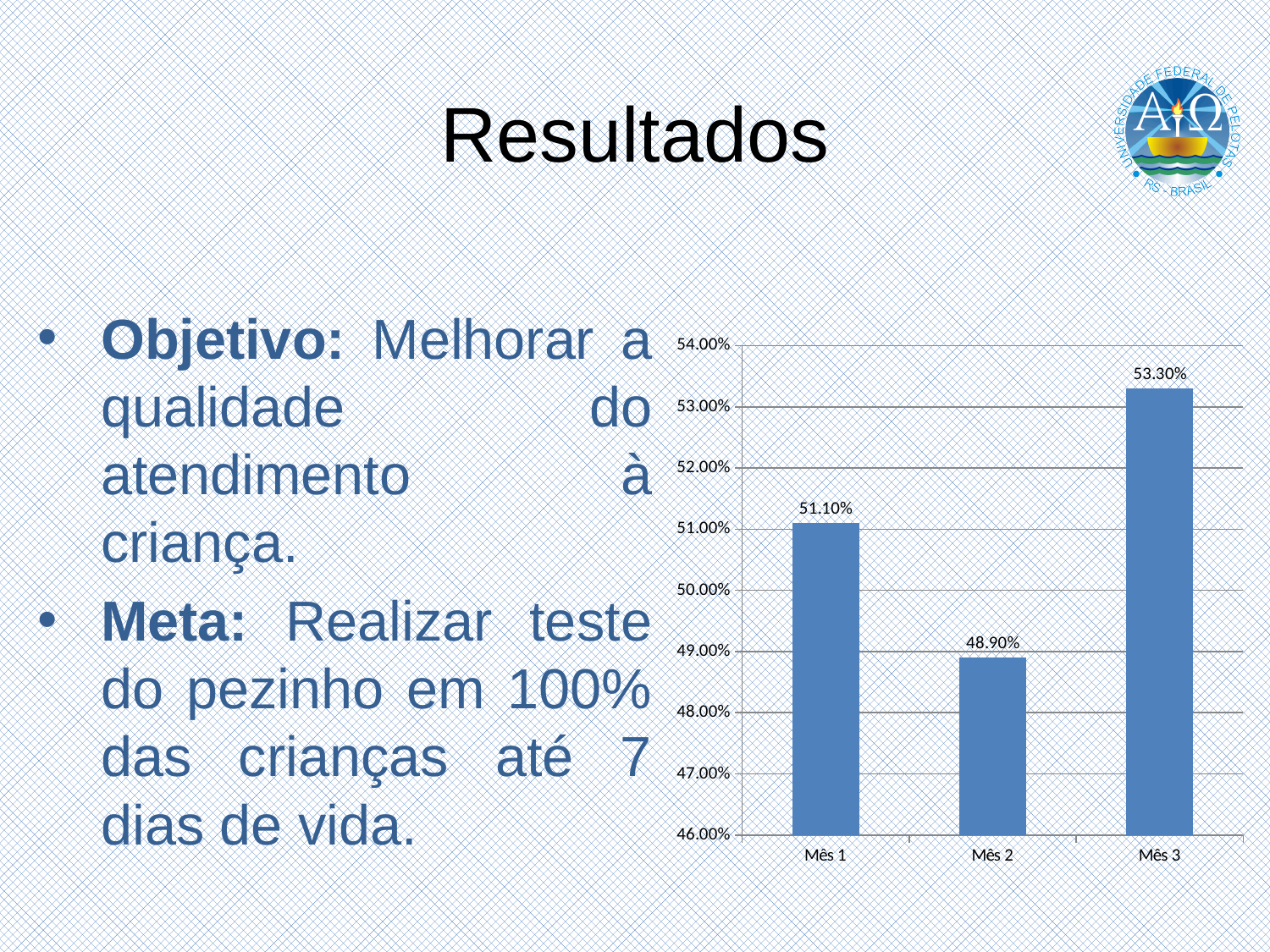
What is the value for Mês 2? 48.90% Which month has the highest value? Mês 3 Is the value for Mês 2 greater or less than 50.00%? less What is the difference between the values for Mês 1 and Mês 2? 2.20% How many categories are shown on the x axis? 3 Which is larger, the value for Mês 1 or the value for Mês 3? Mês 3 Which month has the lowest value? Mês 2 What is the lowest value shown on the y axis? 46.00% What is the value for Mês 3? 53.30% What is the value for Mês 1? 51.10% What is the difference between the values for Mês 3 and Mês 2? 4.40% What kind of chart is shown on the slide? bar chart